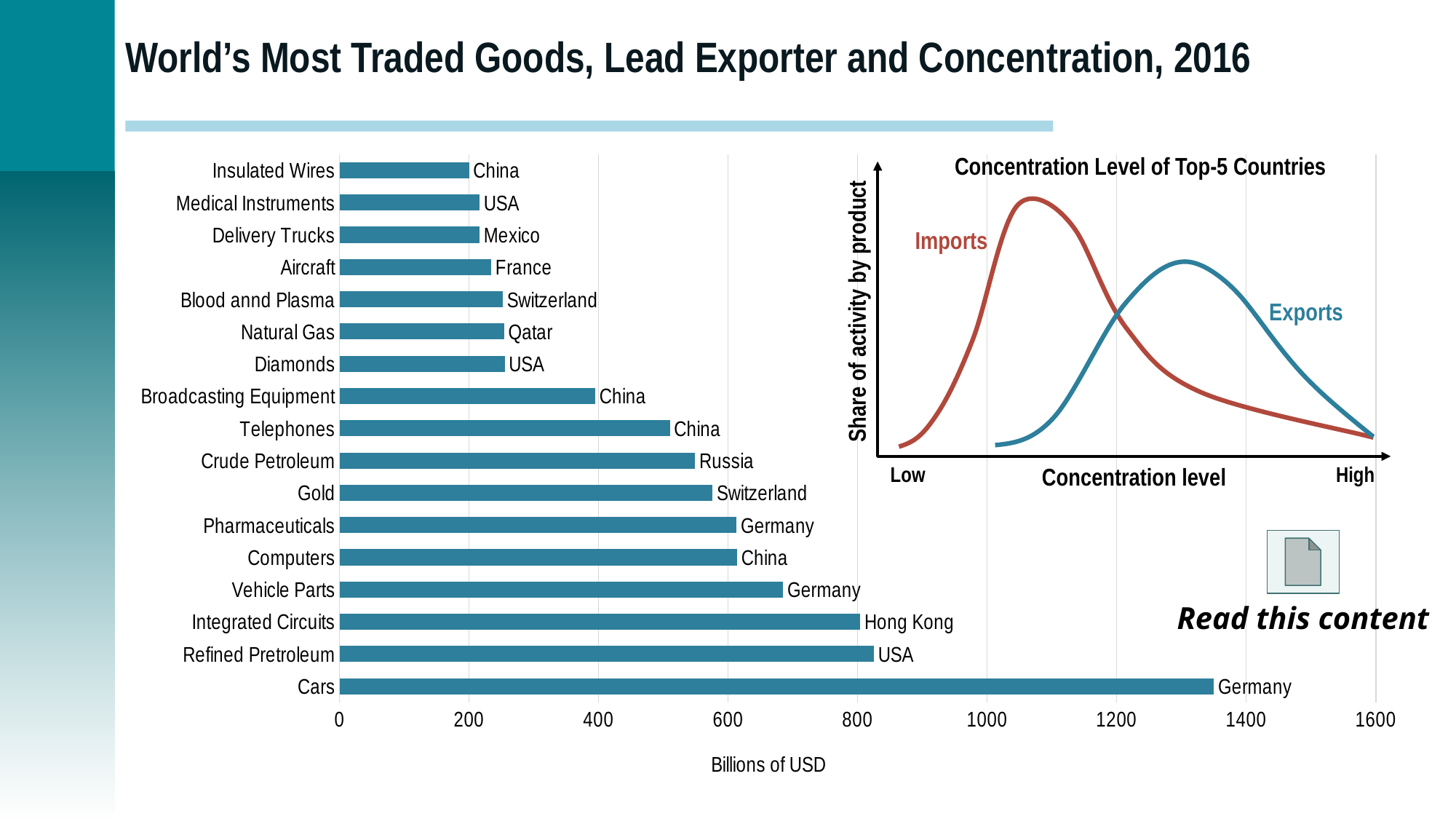
In the chart titled 'Concentration Level of Top-5 Countries', which curve peaks at the higher concentration level, Imports or Exports? Exports In the bar chart, is the value for Crude Petroleum greater or less than 600? less In the bar chart, which country is labelled as the lead exporter for Gold? Switzerland In the bar chart, is the value for Cars greater or less than 1200? greater In the bar chart, which country is labelled as the lead exporter for Integrated Circuits? Hong Kong In the bar chart, which is larger, the value for Telephones or the value for Broadcasting Equipment? Telephones What is the x-axis title of the bar chart? Billions of USD In the bar chart, is the value for Vehicle Parts greater or less than 600? greater What kind of chart is the main chart on the left of the slide? bar chart In the bar chart, which country is labelled as the lead exporter for Natural Gas? Qatar In the bar chart, how many goods are listed? 17 In the bar chart, which good has the highest traded value? Cars